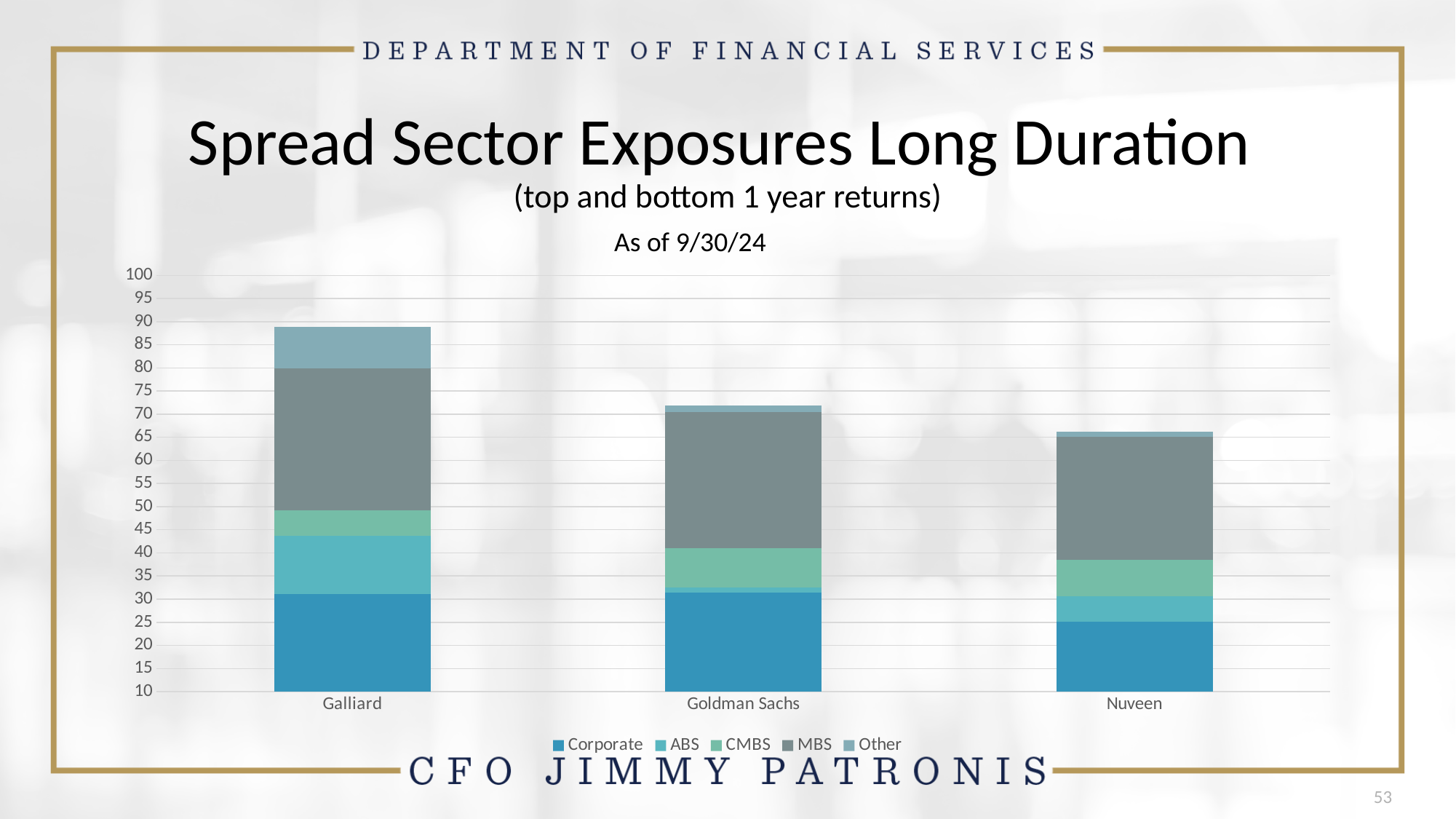
Is the top of the Goldman Sachs stacked bar greater or less than 80? less Which manager has the shortest stacked bar? Nuveen Which manager has the tallest stacked bar? Galliard Which stacked bar is taller, Goldman Sachs or Nuveen? Goldman Sachs How many managers (categories) are shown on the x axis? 3 What is the 'as of' date shown above the chart? 9/30/24 Is the top of the Galliard stacked bar greater or less than 85? greater How many series does the legend list? 5 Which series forms the largest segment of the Goldman Sachs bar? Corporate Is the top of the Nuveen stacked bar greater or less than 70? less What kind of chart is shown on the slide? Stacked bar chart Which stacked bar is taller, Galliard or Goldman Sachs? Galliard